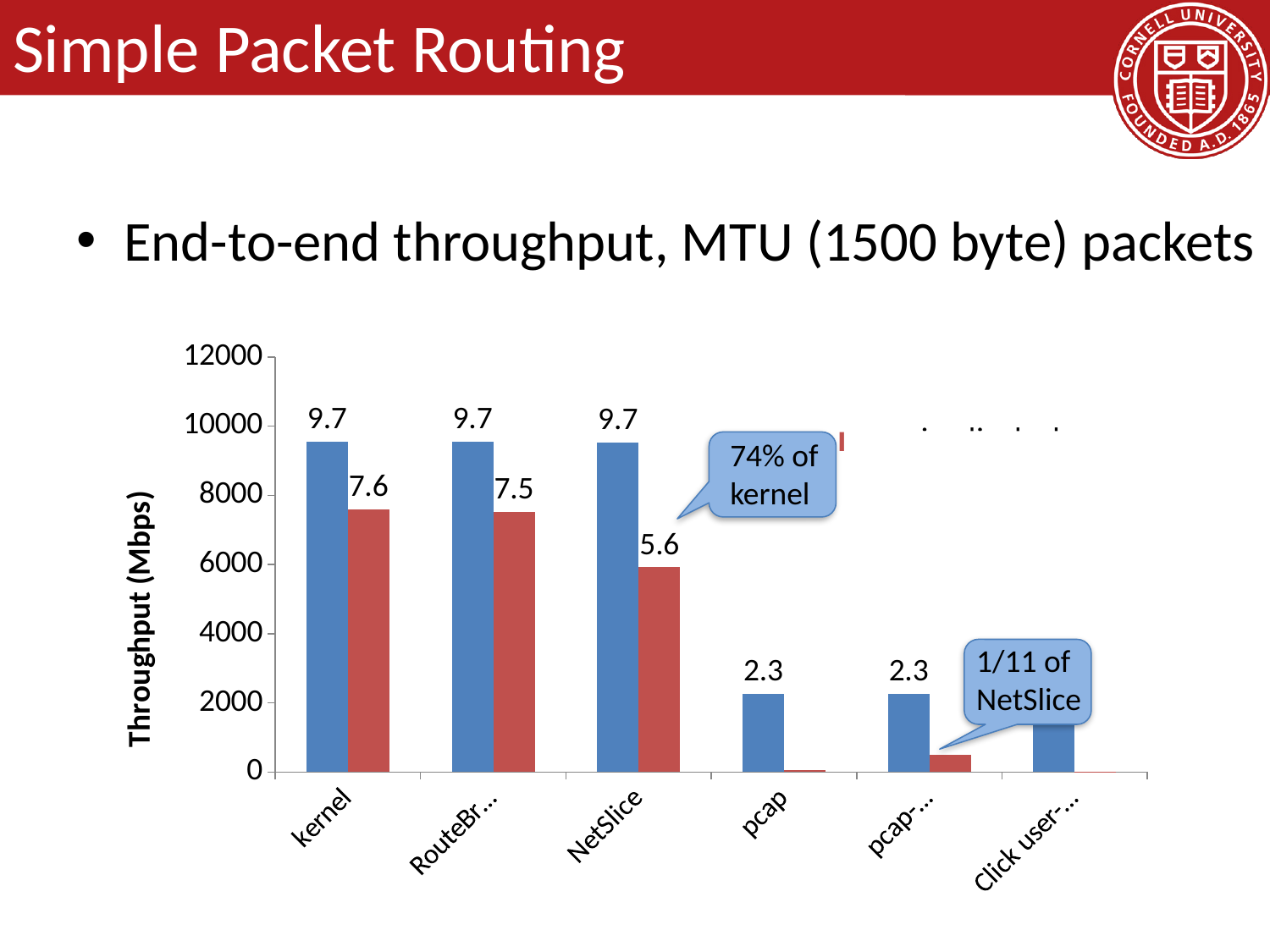
What does the callout pointing at the red NetSlice bar say? 74% of kernel What is the data label on the red bar for NetSlice? 5.6 Is the red bar for pcap greater or less than 2000? less What is the data label on the red bar for kernel? 7.6 What is the difference between the blue and red data labels for kernel? 2.1 Which is larger, the red bar for kernel or the red bar for NetSlice? kernel What kind of chart is shown on the slide? bar chart What is the data label on the blue bar for kernel? 9.7 What is the data label on the blue bar for pcap? 2.3 How many categories are shown on the x axis of the chart? 6 What is the title of the y axis? Throughput (Mbps) Which category has the lowest blue bar? Click user-...